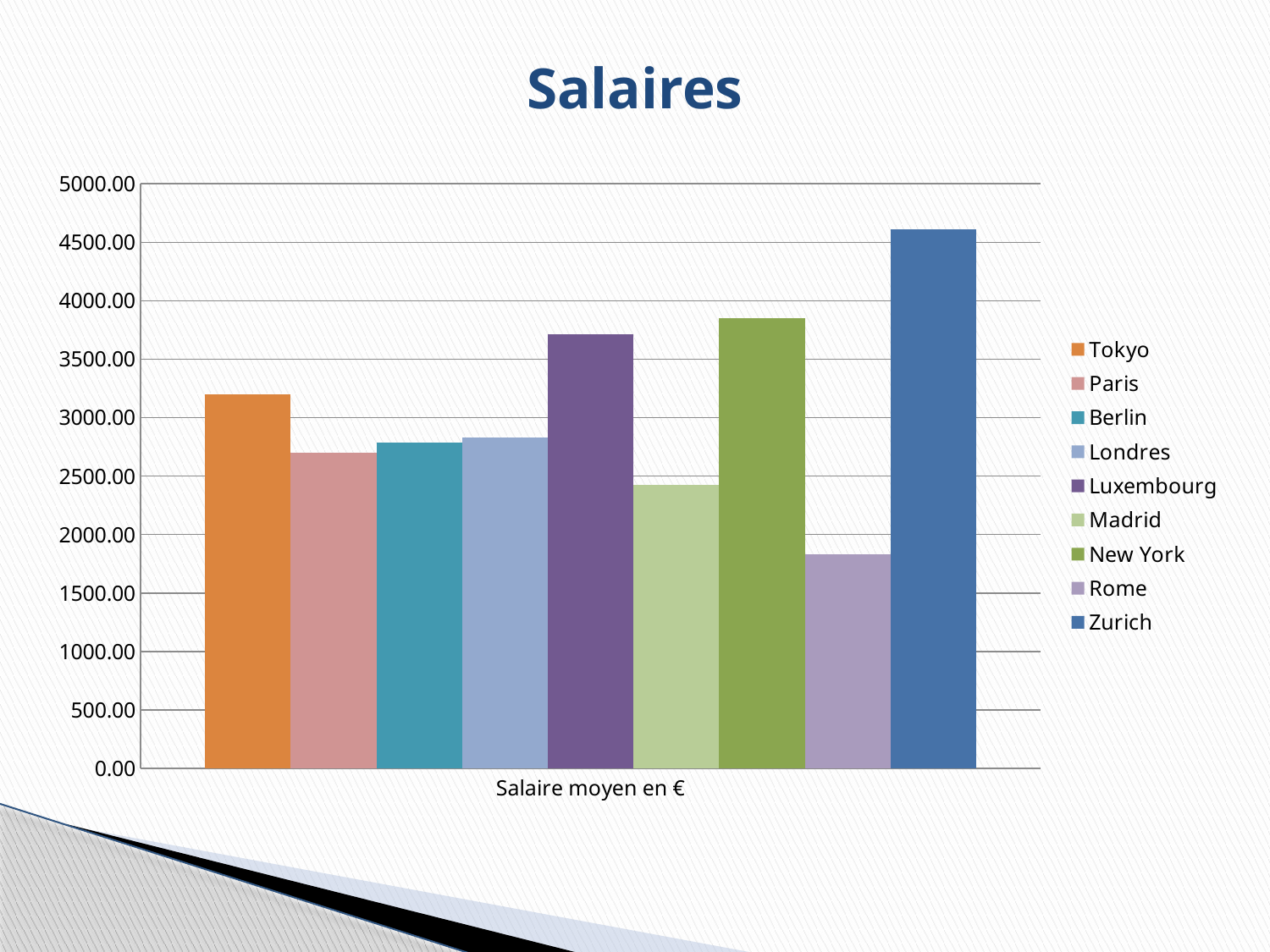
Which is larger, the value for New York or the value for Madrid? New York What kind of chart is shown on the slide? bar chart Which is larger, the value for Tokyo or the value for Paris? Tokyo Is the value for Madrid greater or less than 2500? less Which city has the lowest average salary? Rome How many series does the legend list? 9 Is the value for Rome greater or less than 2000? less What is the title of the chart? Salaires Is the value for Tokyo greater or less than 3000? greater Which city has the highest average salary? Zurich